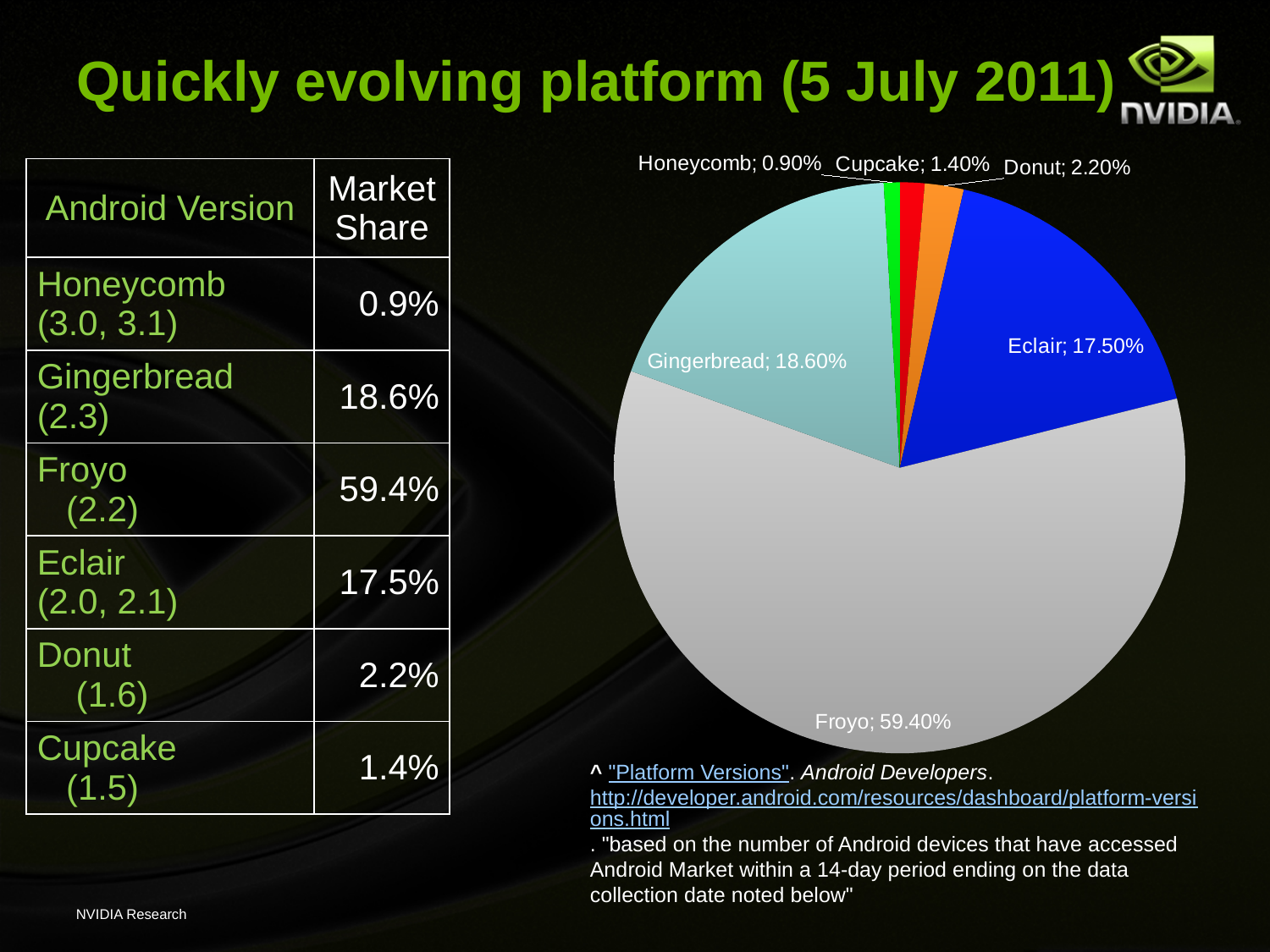
Which slice of the pie chart is the smallest? Honeycomb What is the value shown for Gingerbread in the pie chart? 18.60% What is the difference between the Froyo and Gingerbread values in the pie chart? 40.80% What kind of chart is shown on the slide? pie chart How many slices does the pie chart have? 6 What share of the pie does the Eclair slice represent? 17.50% What is the value shown for Honeycomb in the pie chart? 0.90% What is the difference between the Donut and Cupcake values in the pie chart? 0.80% What is the value shown for Froyo in the pie chart? 59.40% Which slice of the pie chart is the largest? Froyo In the pie chart, which is larger, Gingerbread or Eclair? Gingerbread What is the value shown for Eclair in the pie chart? 17.50%